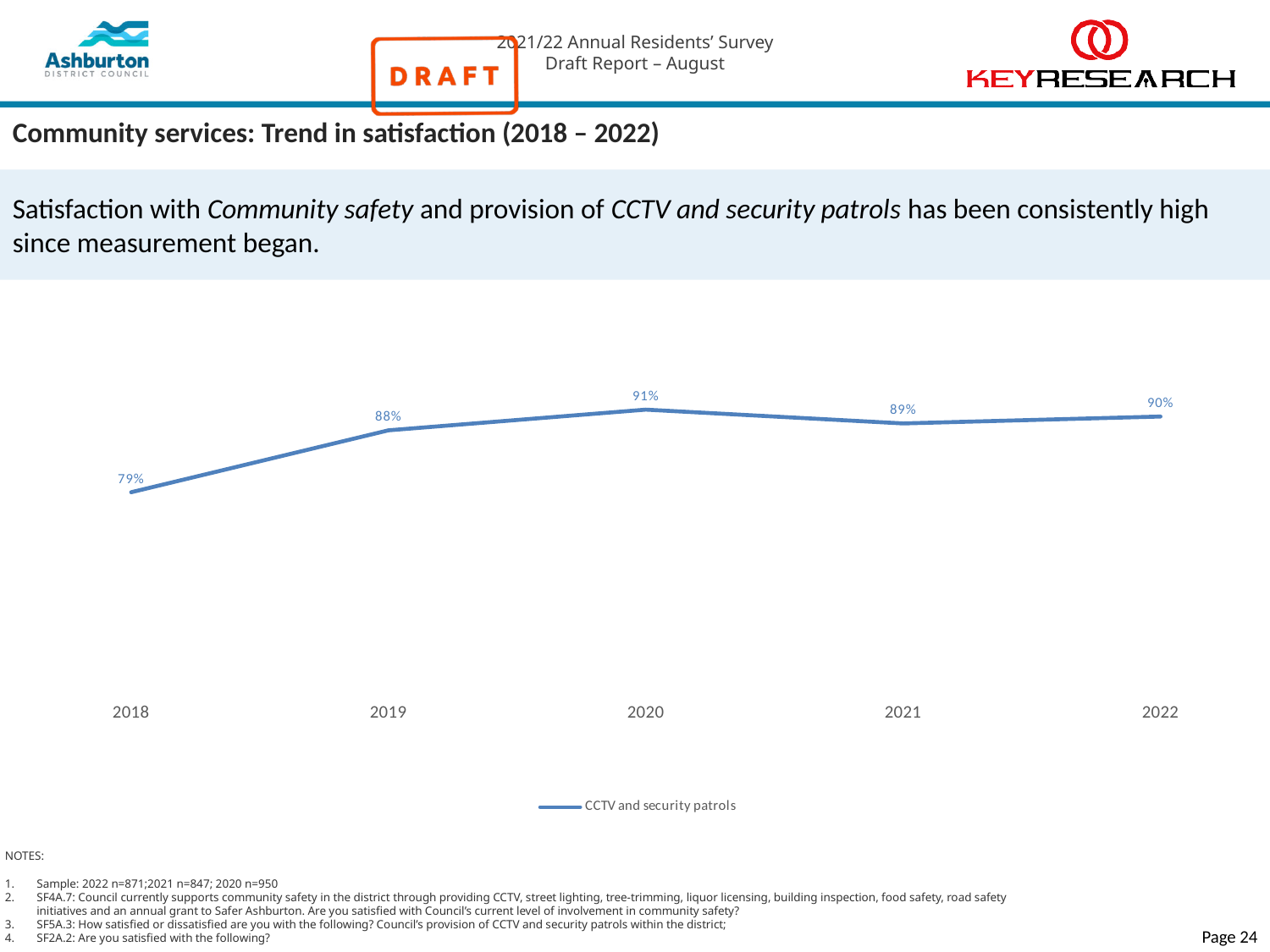
What is the difference between the 2020 and 2021 satisfaction values for CCTV and security patrols? 2 What type of chart is shown on the slide? Line chart What is the name of the series shown in the legend? CCTV and security patrols By how many percentage points did satisfaction with CCTV and security patrols change from 2018 to 2019? 9 How many years are plotted on the chart? 5 In which year was satisfaction with CCTV and security patrols highest? 2020 Which year had a higher satisfaction value, 2019 or 2021? 2021 What was the satisfaction value for CCTV and security patrols in 2020? 91% In which year was satisfaction with CCTV and security patrols lowest? 2018 How many series does the legend list? 1 What was the satisfaction value for CCTV and security patrols in 2022? 90% What was the satisfaction value for CCTV and security patrols in 2018? 79%